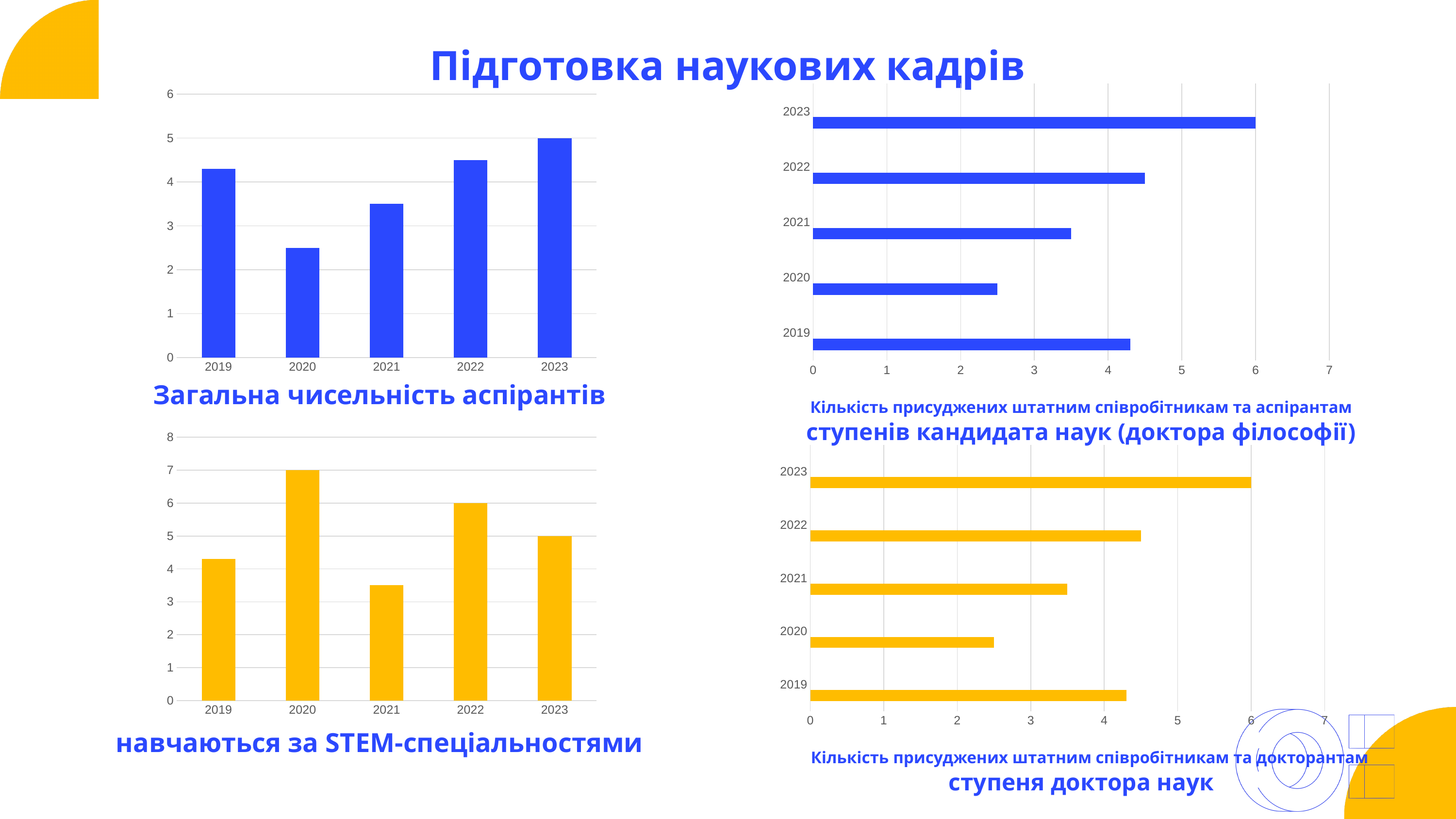
In the bottom-left chart "навчаються за STEM-спеціальностями", which year has the highest value? 2020 In the top-right chart about ступенів кандидата наук (доктора філософії), which year has the lowest value? 2020 What kind of chart is the top-left chart titled "Загальна чисельність аспірантів"? bar chart In the top-left chart "Загальна чисельність аспірантів", is the value for 2020 greater or less than 3? less In the top-left chart "Загальна чисельність аспірантів", which year has the lowest value? 2020 In the bottom-left chart "навчаються за STEM-спеціальностями", what is the value for 2022? 6 In the top-left chart "Загальна чисельність аспірантів", what is the value for 2023? 5 In the top-right chart about ступенів кандидата наук (доктора філософії), what is the value for 2023? 6 In the top-left chart "Загальна чисельність аспірантів", which year has the highest value? 2023 In the bottom-left chart "навчаються за STEM-спеціальностями", which is larger, the value for 2021 or the value for 2023? 2023 In the bottom-right chart about ступеня доктора наук, is the value for 2021 greater or less than 4? less How many years are shown on the x axis of the bottom-left chart "навчаються за STEM-спеціальностями"? 5